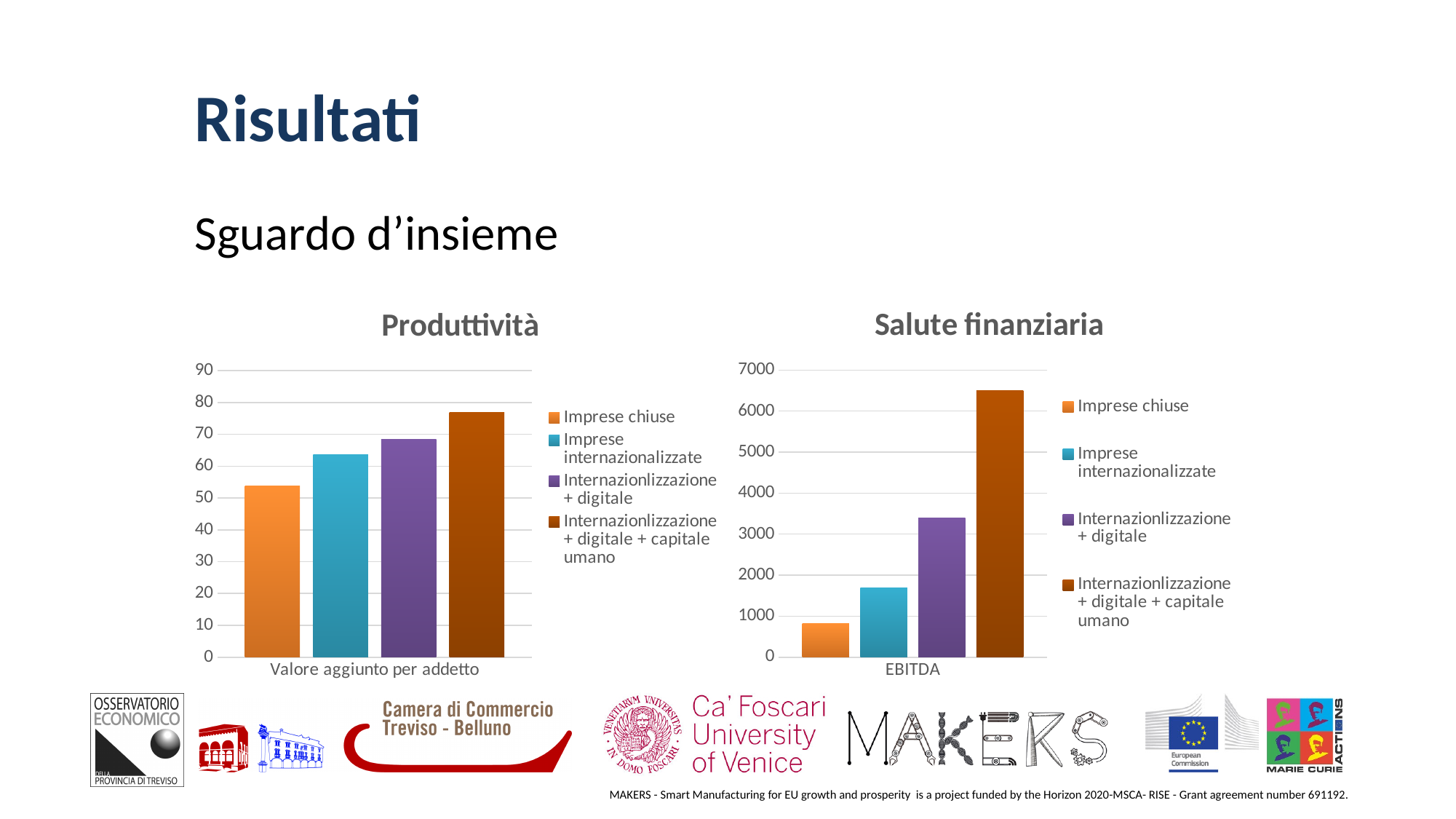
In the 'Salute finanziaria' chart, is the value for Imprese internazionalizzate greater or less than 2000? less In the 'Produttività' chart, do the bars rise or fall from left to right across the series? rise In the 'Produttività' chart, which series has the highest value? Internazionlizzazione + digitale + capitale umano In the 'Salute finanziaria' chart, which series has the highest EBITDA? Internazionlizzazione + digitale + capitale umano What is the category label on the x axis of the 'Salute finanziaria' chart? EBITDA In the 'Salute finanziaria' chart, which series has the lowest EBITDA? Imprese chiuse In the 'Salute finanziaria' chart, is the value for Internazionlizzazione + digitale + capitale umano greater or less than 6000? greater In the 'Salute finanziaria' chart, which is larger: Imprese internazionalizzate or Internazionlizzazione + digitale? Internazionlizzazione + digitale What kind of chart is the 'Produttività' chart? bar chart In the 'Produttività' chart, is the value for Imprese chiuse greater or less than 60? less How many series does the legend of the 'Salute finanziaria' chart list? 4 In the 'Produttività' chart, which series has the lowest value? Imprese chiuse